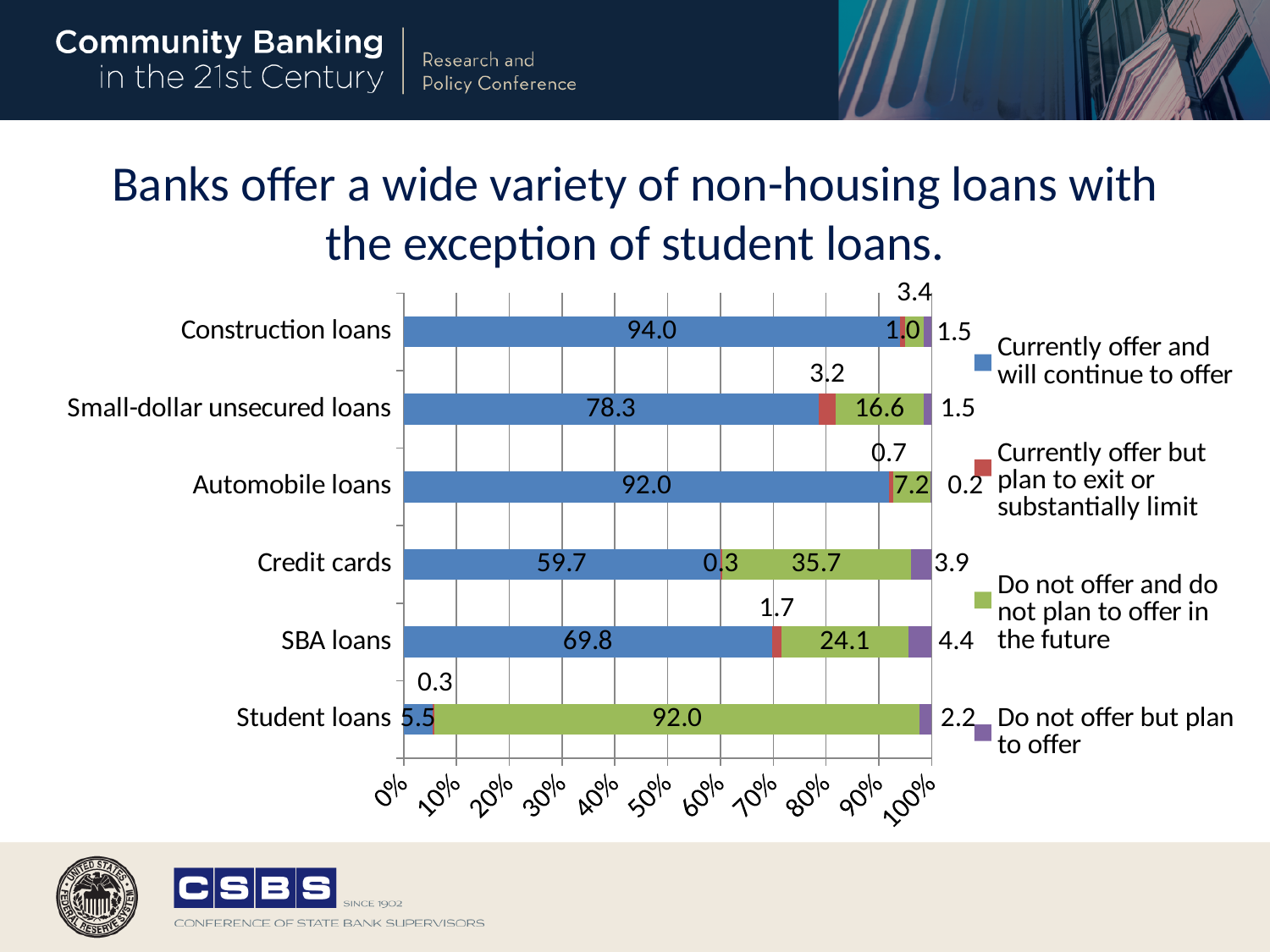
What type of chart is shown on the slide? Bar chart How many series does the legend list? 4 What is the difference between the 'Currently offer and will continue to offer' values for construction loans and small-dollar unsecured loans? 15.7 Which loan type has the highest share of banks that currently offer and will continue to offer it? Construction loans How many loan types are shown in the chart? 6 What percentage of banks currently offer and will continue to offer construction loans? 94.0 What percentage of banks currently offer and will continue to offer student loans? 5.5 What percentage of banks do not offer and do not plan to offer SBA loans in the future? 24.1 Which loan type has the lowest share of banks that currently offer and will continue to offer it? Student loans What percentage of banks do not offer and do not plan to offer credit cards in the future? 35.7 What colour represents 'Do not offer and do not plan to offer in the future' in the chart? Green Which has a larger 'Currently offer and will continue to offer' value: SBA loans or credit cards? SBA loans